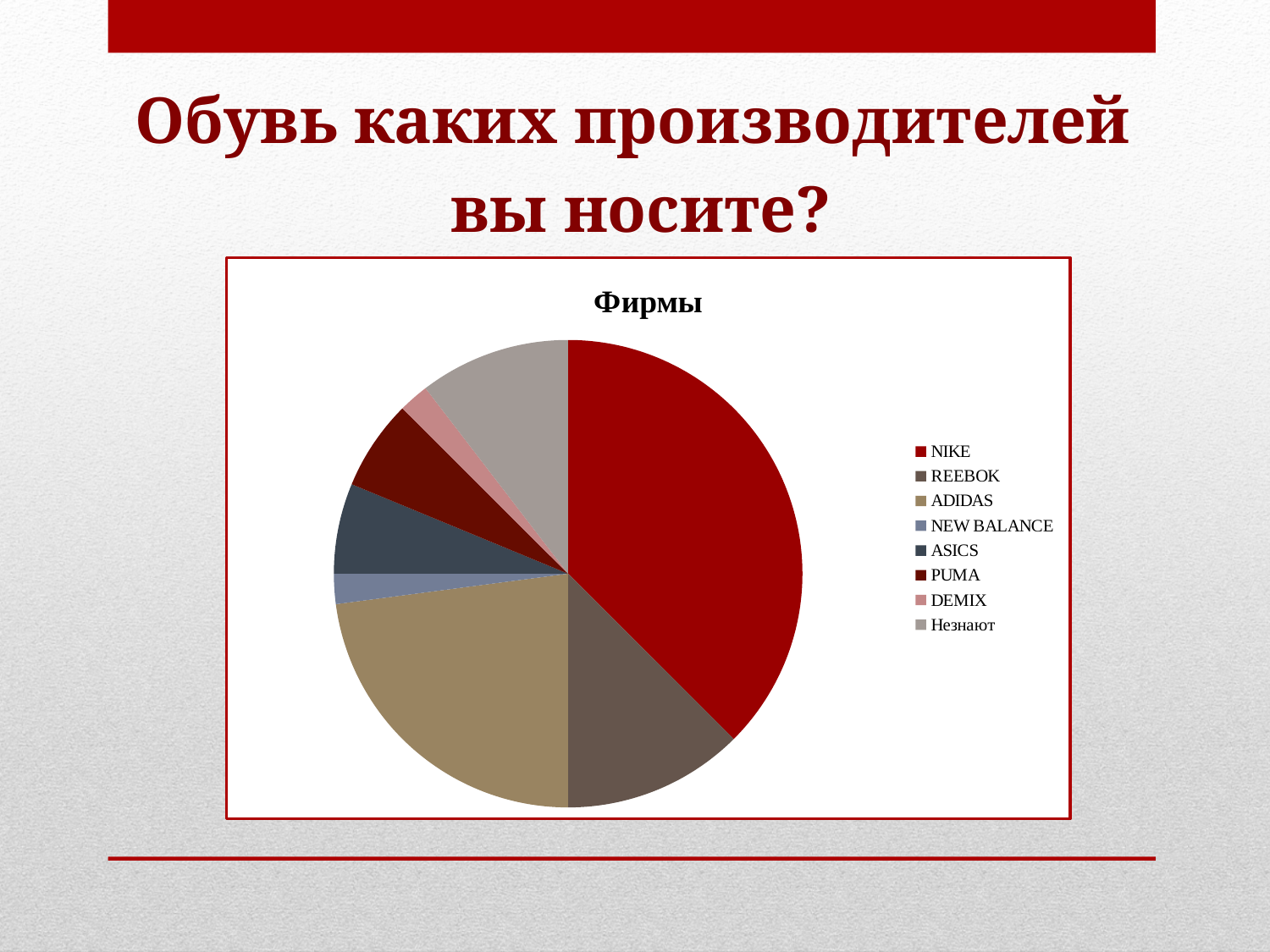
How many entries does the legend list? 8 What kind of chart is shown on the slide? pie chart What colour is the NIKE slice in the pie chart? red Which is larger, the slice for ASICS or the slice for NEW BALANCE? ASICS Which is larger, the slice for Незнают or the slice for PUMA? Незнают Which is larger, the slice for REEBOK or the slice for ASICS? REEBOK Which category has the largest slice of the pie? NIKE How many categories does the pie chart have? 8 What is the title of the chart? Фирмы